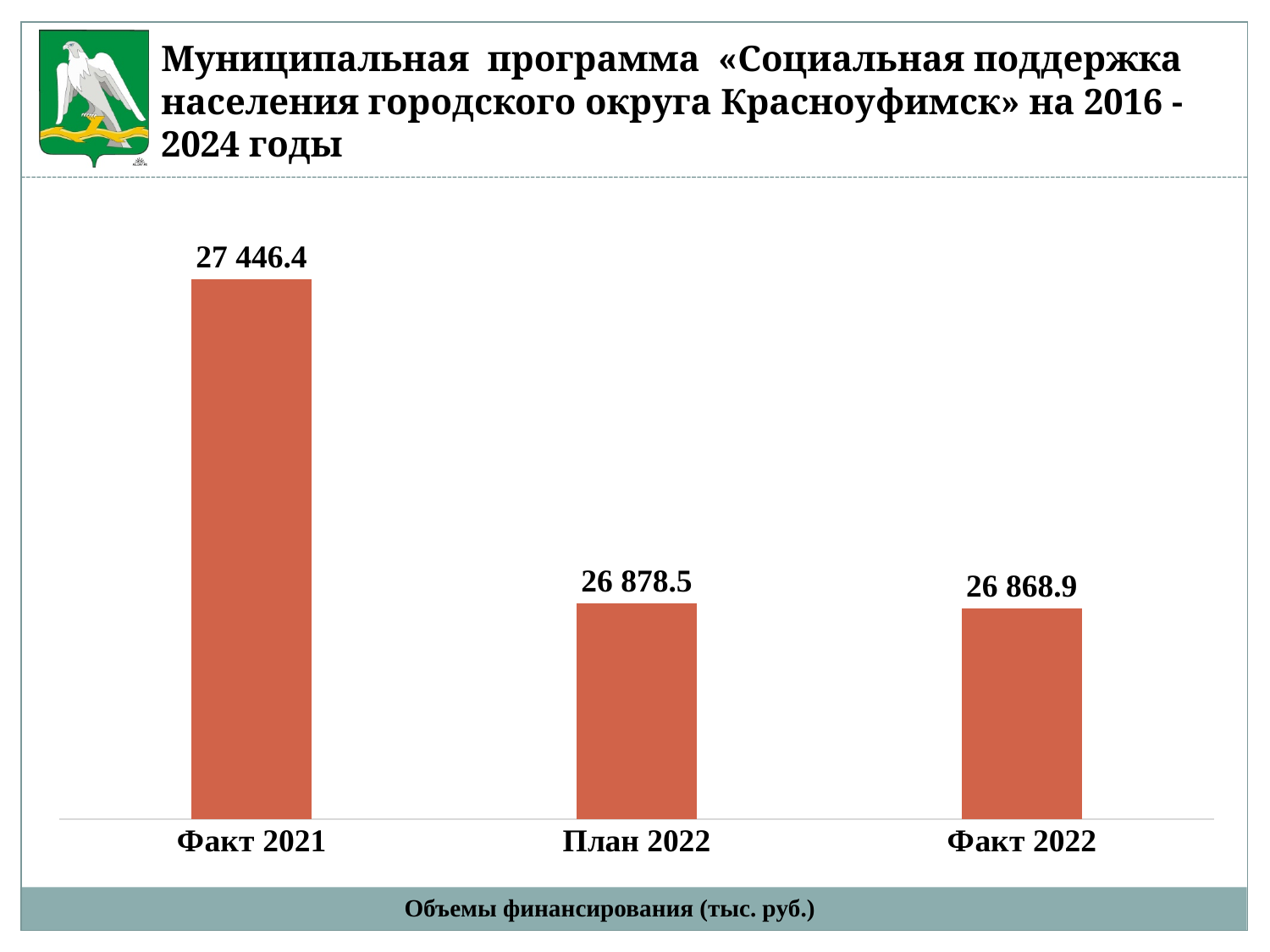
What is the difference between the values for План 2022 and Факт 2022? 9.6 What is the value for План 2022? 26 878.5 What is the value for Факт 2021? 27 446.4 What kind of chart is shown on the slide? Bar chart Which is larger, the value for Факт 2021 or the value for План 2022? Факт 2021 What unit is given in the caption below the chart? тыс. руб. Which category has the highest value? Факт 2021 What is the value for Факт 2022? 26 868.9 What is the difference between the values for Факт 2021 and Факт 2022? 577.5 How many categories are shown in the chart? 3 What is the difference between the values for Факт 2021 and План 2022? 567.9 Do the values rise or fall from Факт 2021 to Факт 2022? Fall